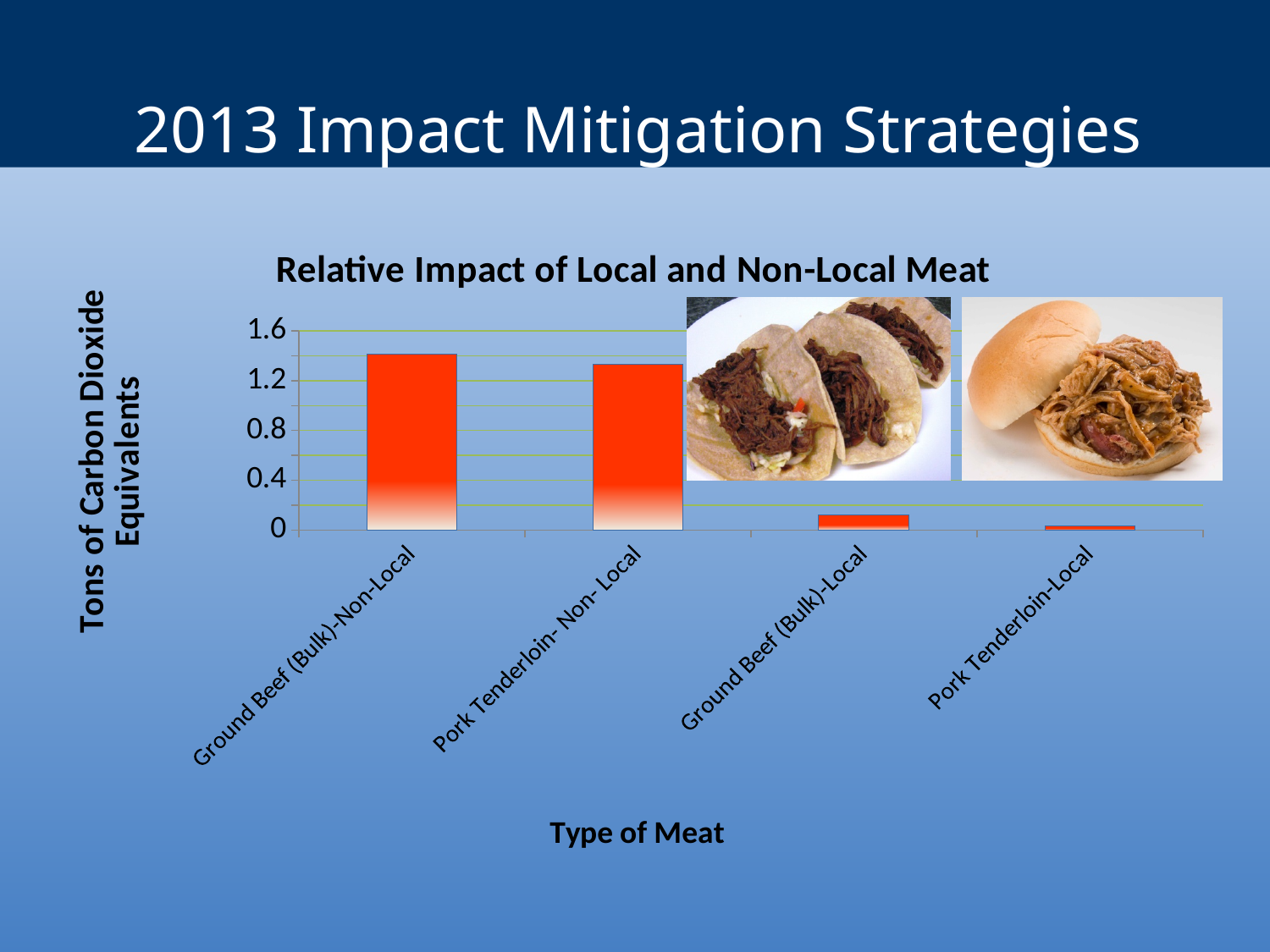
What is the label of the vertical axis? Tons of Carbon Dioxide Equivalents Is the value for Pork Tenderloin- Non- Local greater or less than 0.8? greater Is the value for Pork Tenderloin-Local greater or less than 0.4? less Which has a larger value, Ground Beef (Bulk)-Non-Local or Ground Beef (Bulk)-Local? Ground Beef (Bulk)-Non-Local What is the title of the chart? Relative Impact of Local and Non-Local Meat Which type of meat has the lowest value? Pork Tenderloin-Local Is the value for Ground Beef (Bulk)-Local greater or less than 0.4? less What type of chart is shown on the slide? Bar chart How many types of meat are plotted on the chart? 4 Which type of meat has the highest value? Ground Beef (Bulk)-Non-Local Do the values rise or fall moving from left to right along the x axis? fall